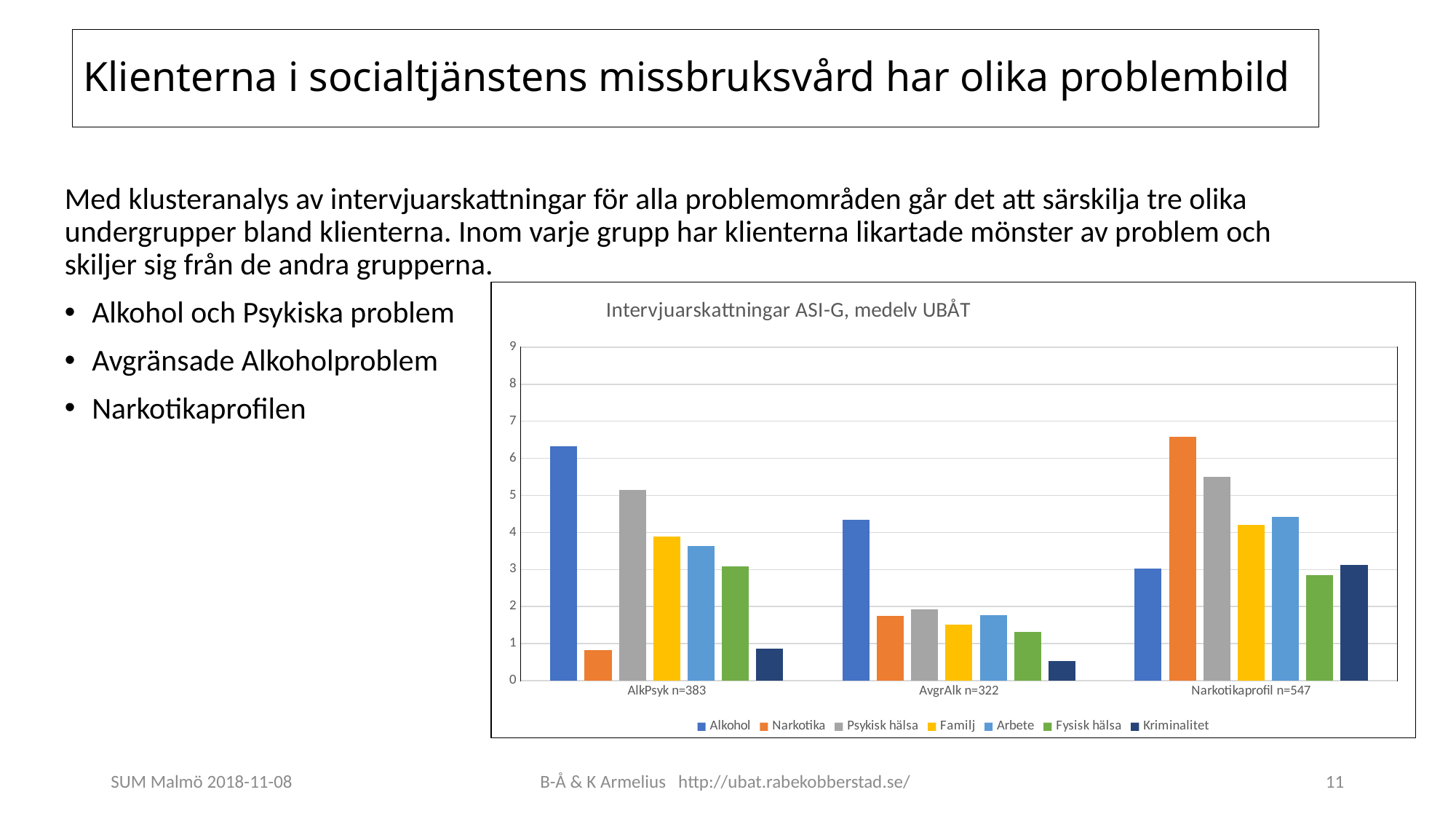
Which group has the higher value for Alkohol: AlkPsyk n=383 or AvgrAlk n=322? AlkPsyk n=383 In the AvgrAlk n=322 group, which problem area has the lowest value? Kriminalitet Is the value for Narkotika in the AvgrAlk n=322 group greater or less than 2? less What kind of chart is shown on the slide? Bar chart In the AlkPsyk n=383 group, which problem area has the highest value? Alkohol Which group has the higher value for Psykisk hälsa: AvgrAlk n=322 or Narkotikaprofil n=547? Narkotikaprofil n=547 What is the title of the chart? Intervjuarskattningar ASI-G, medelv UBÅT How many client groups (categories) are shown on the x axis of the chart? 3 In the Narkotikaprofil n=547 group, which problem area has the highest value? Narkotika Is the value for Narkotika in the Narkotikaprofil n=547 group greater or less than 6? greater Is the value for Alkohol in the AlkPsyk n=383 group greater or less than 5? greater How many series does the legend of the chart list? 7